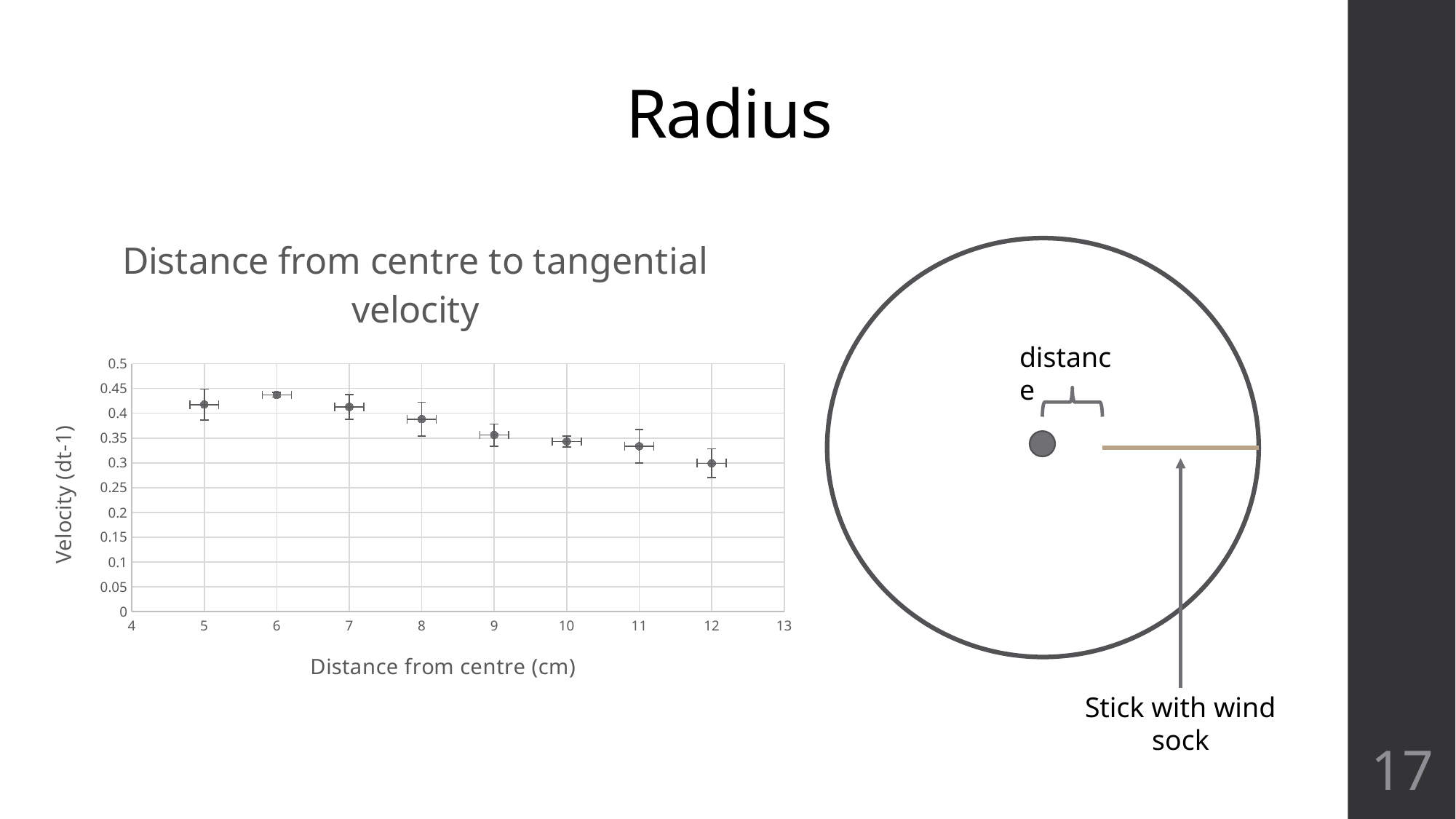
What is the title of the chart? Distance from centre to tangential velocity Which has the higher velocity: the point at 5 cm or the point at 12 cm? 5 cm Is the velocity at a distance of 12 cm greater or less than 0.35? less Which has the higher velocity: the point at 7 cm or the point at 11 cm? 7 cm Is the velocity at a distance of 8 cm greater or less than 0.45? less At which distance from centre is the velocity lowest? 12 How many data points are plotted on the chart? 8 Is the velocity at a distance of 5 cm greater or less than 0.4? greater Do the velocity values generally rise or fall as the distance from centre increases? Fall What kind of chart is shown on the slide? Scatter chart What is the label of the x axis of the chart? Distance from centre (cm)